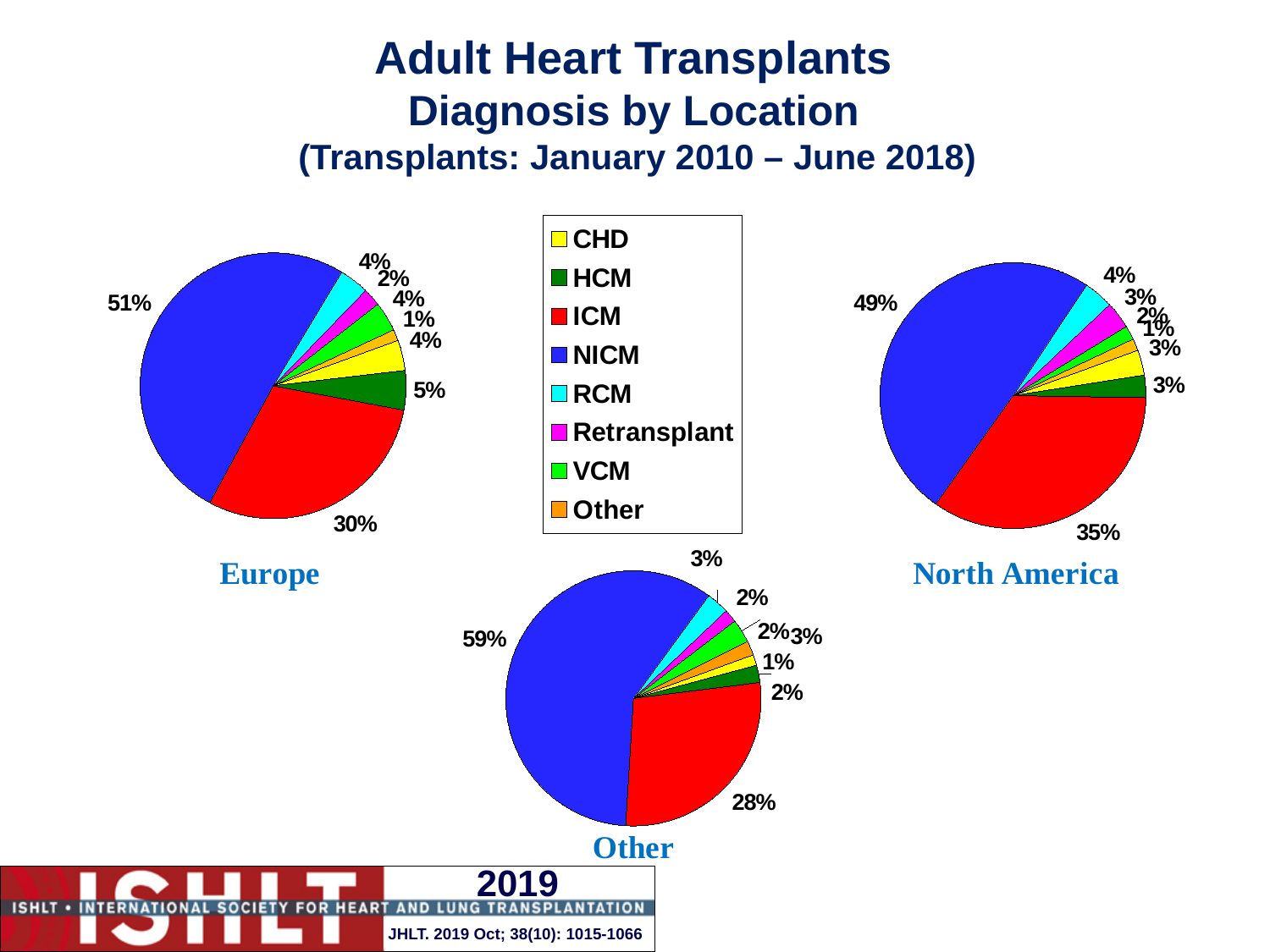
In the North America pie chart, what share of adult heart transplants is for ICM? 35% In the Europe pie chart, what share is for HCM? 5% How many diagnosis categories does the legend list? 8 In the Europe pie chart, what is the difference between the NICM share and the ICM share? 21 percentage points How many pie charts are on the slide? 3 In the North America pie chart, which diagnosis has the largest share? NICM Which pie chart shows a larger ICM share, Europe or North America? North America In the Europe pie chart, which diagnosis has the largest share? NICM In the Other pie chart, what is the difference between the NICM share and the ICM share? 31 percentage points In the Europe pie chart, what share of adult heart transplants is for NICM? 51% What kind of charts are shown on the slide? Pie charts In the Other pie chart, what share of adult heart transplants is for NICM? 59%